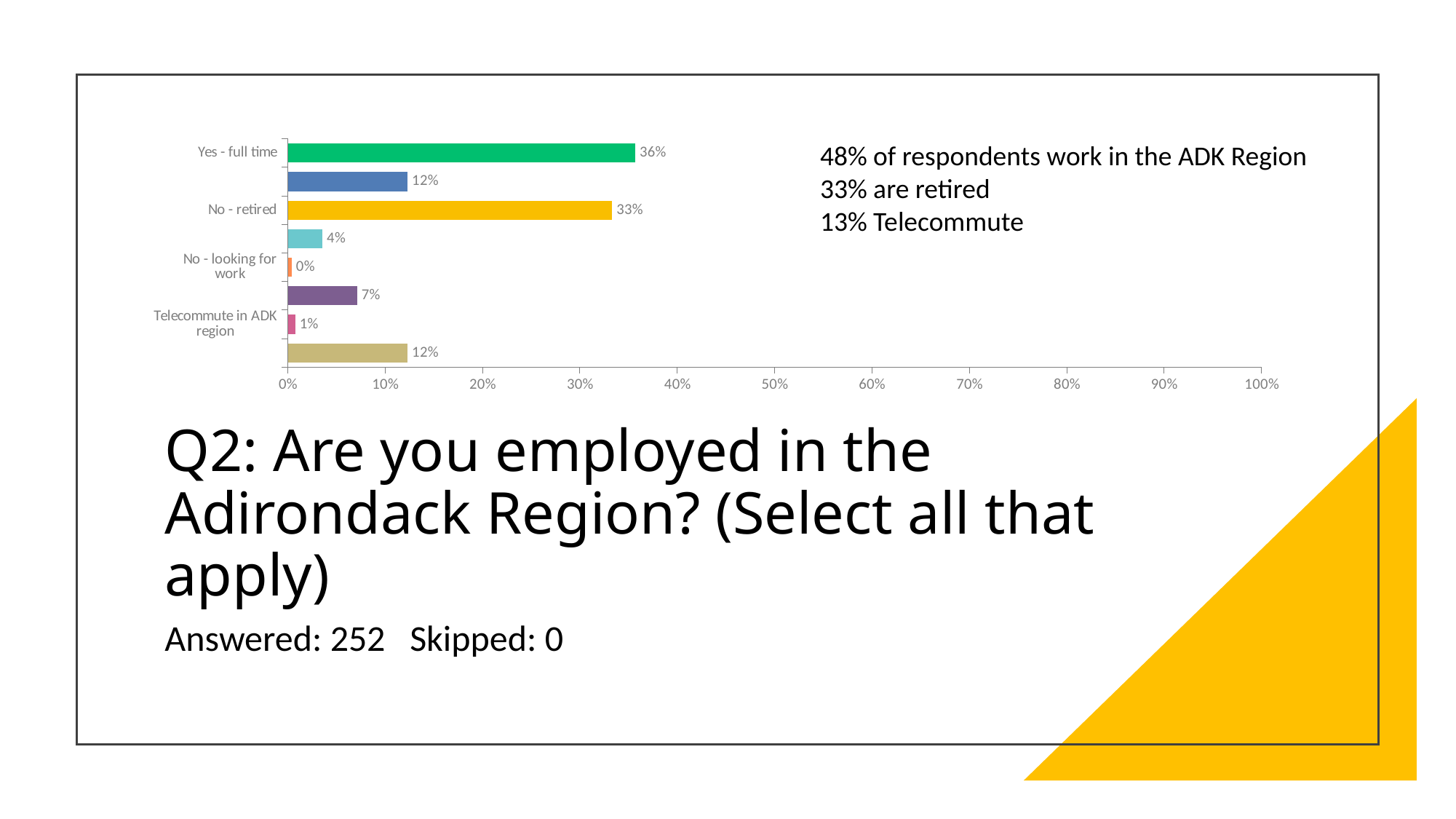
Is the value for "Yes - full time" greater or less than 30%? greater What is the value for "Telecommute in ADK region"? 1% What is the value for "Yes - full time"? 36% How many bars are plotted in the chart? 8 What kind of chart is shown on the slide? bar chart Which labeled category has the lowest value? No - looking for work What is the value for "No - looking for work"? 0% What is the value for "No - retired"? 33% What is the highest value shown on the horizontal axis? 100% Which labeled category has the highest value? Yes - full time Which is larger, the value for "Yes - full time" or the value for "No - retired"? Yes - full time What is the difference between the values for "Yes - full time" and "No - retired"? 3%